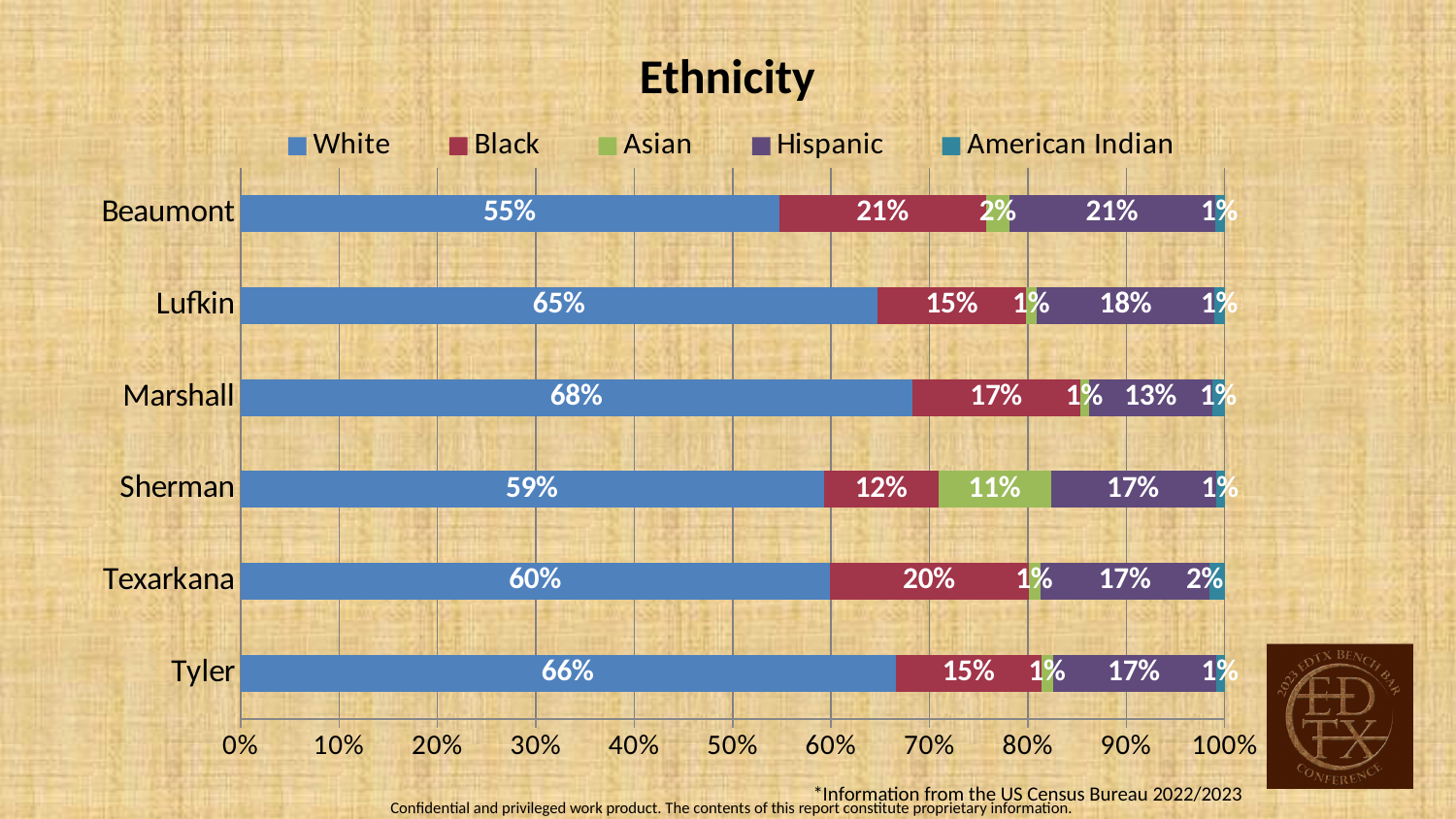
How many series does the legend list? 5 What is the American Indian percentage for Texarkana? 2% Which city has the highest White percentage? Marshall Which is larger, the Hispanic percentage in Marshall or in Tyler? Tyler What type of chart is shown on the slide? Stacked bar chart What percentage of Beaumont's population is White? 55% What is the difference between the Black percentage in Beaumont and in Sherman? 9% Which city has the lowest White percentage? Beaumont What is the Hispanic percentage for Lufkin? 18% How many cities are shown on the chart? 6 What is the Asian share for Sherman? 11% Which city has the highest Asian percentage? Sherman